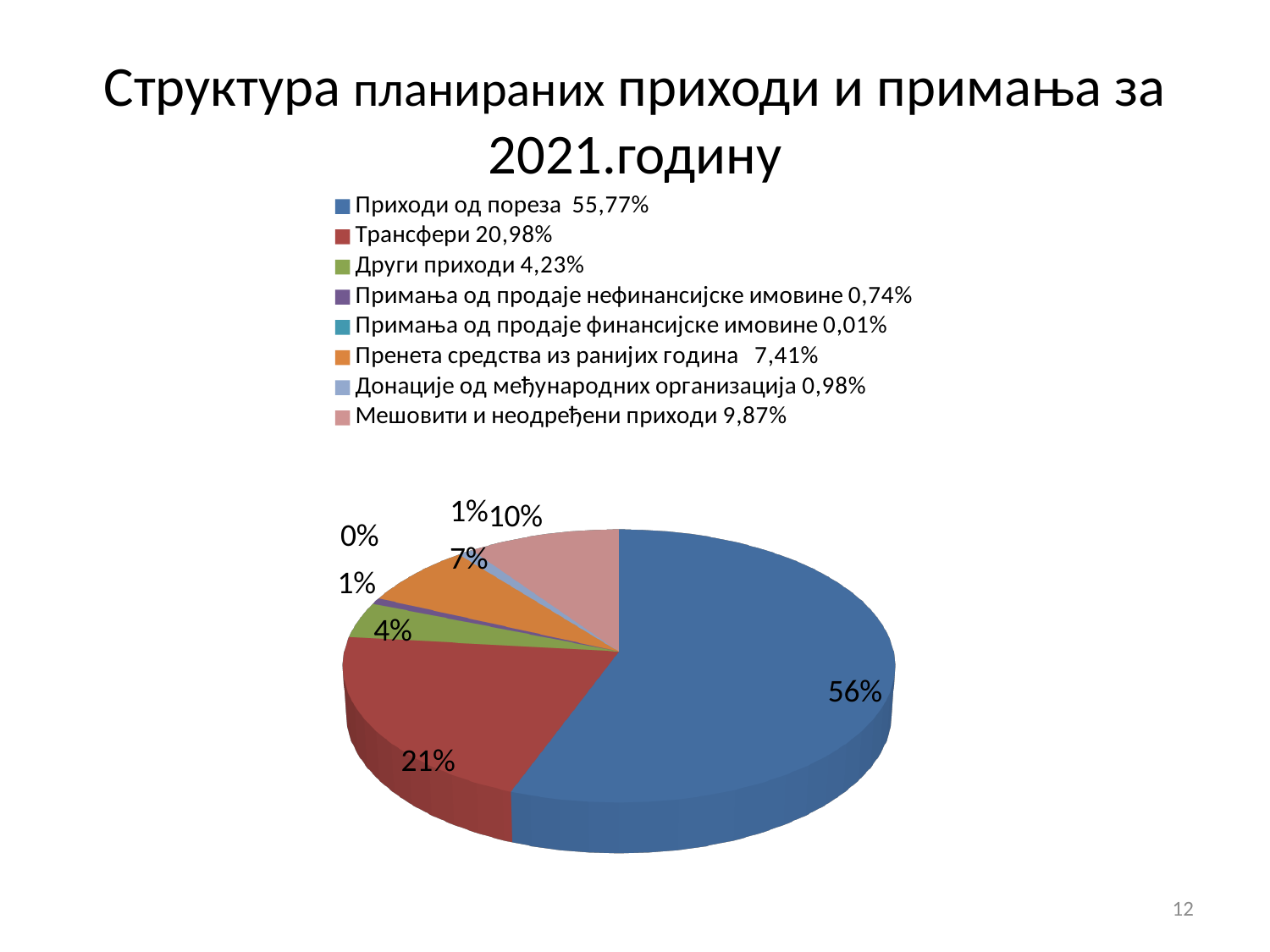
What share of the pie does Мешовити и неодређени приходи have according to the legend? 9,87% What percentage is shown in the legend for Пренета средства из ранијих година? 7,41% How many categories does the legend of the pie chart list? 8 What kind of chart is shown on the slide? pie chart What percentage is shown in the legend for Трансфери? 20,98% What is the title of the chart slide? Структура планираних приходи и примања за 2021.годину What data label is printed on the red slice (Трансфери) of the pie chart? 21% What data label is printed on the largest (blue) slice of the pie chart? 56% Using the data labels on the pie, what is the difference between the largest slice (56%) and the Трансфери slice (21%)? 35 percentage points Which category has the largest slice of the pie chart? Приходи од пореза Which is larger: the share of Други приходи or the share of Пренета средства из ранијих година? Пренета средства из ранијих година Which category has the smallest share according to the legend? Примања од продаје финансијске имовине